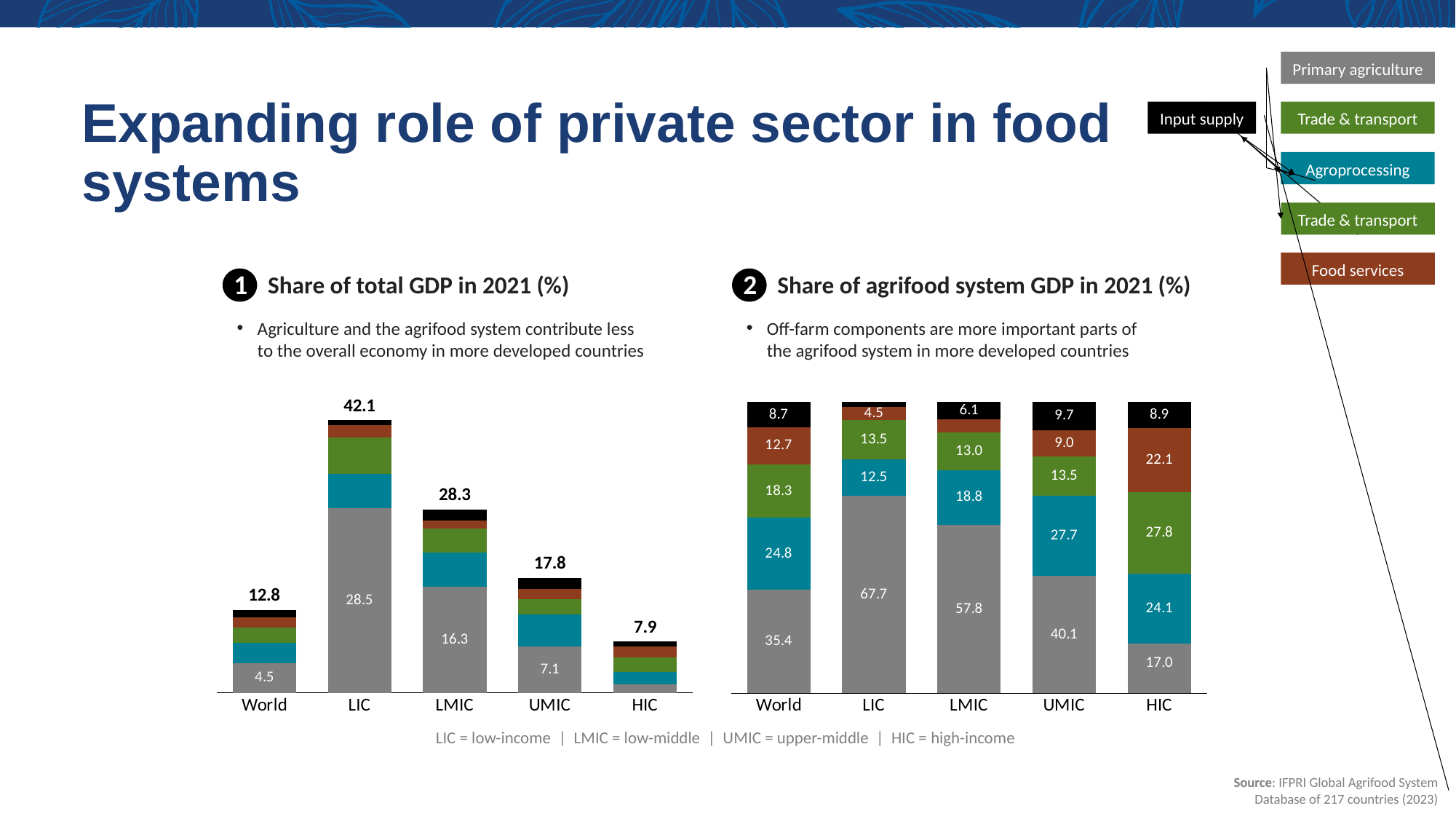
In the 'Share of total GDP in 2021 (%)' chart, what is the difference between the LIC total and the LMIC total? 13.8 In the 'Share of total GDP in 2021 (%)' chart, what is the primary agriculture value for LMIC? 16.3 How many categories are shown on the x axis of the 'Share of total GDP in 2021 (%)' chart? 5 In the 'Share of total GDP in 2021 (%)' chart, which category has the highest total? LIC In the 'Share of total GDP in 2021 (%)' chart, what is the total value labeled above the LIC bar? 42.1 In the 'Share of agrifood system GDP in 2021 (%)' chart, what is the agroprocessing value for UMIC? 27.7 In the 'Share of total GDP in 2021 (%)' chart, which category has the lowest total? HIC In the 'Share of agrifood system GDP in 2021 (%)' chart, does the primary agriculture value rise or fall moving from LIC to HIC? Fall In the 'Share of agrifood system GDP in 2021 (%)' chart, what is the primary agriculture value for HIC? 17.0 What kind of chart is the 'Share of total GDP in 2021 (%)' chart? Stacked bar chart In the 'Share of agrifood system GDP in 2021 (%)' chart, which has the larger food services value, UMIC or HIC? HIC In the 'Share of agrifood system GDP in 2021 (%)' chart, which category has the largest primary agriculture segment? LIC